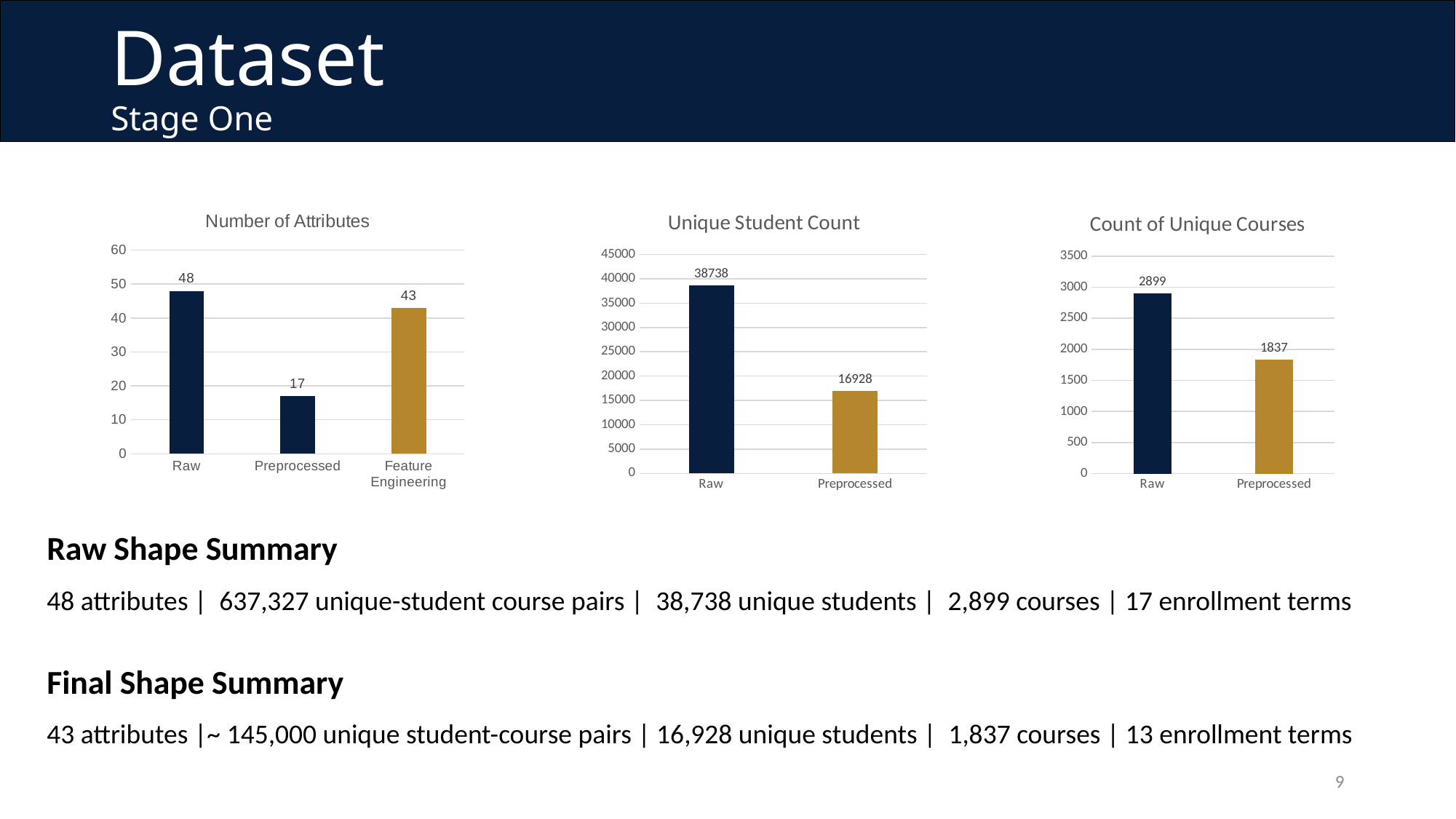
In the 'Unique Student Count' chart, what is the value for Raw? 38738 In the 'Count of Unique Courses' chart, what is the value for Preprocessed? 1837 In the 'Unique Student Count' chart, is the value for Preprocessed greater or less than 20000? less In the 'Number of Attributes' chart, how many categories are shown? 3 In the 'Number of Attributes' chart, what is the value for Feature Engineering? 43 In the 'Count of Unique Courses' chart, what is the difference between the Raw and Preprocessed values? 1062 In the 'Number of Attributes' chart, what is the difference between the Raw and Preprocessed values? 31 In the 'Number of Attributes' chart, what is the value for Preprocessed? 17 In the 'Count of Unique Courses' chart, which category has the highest value? Raw What type of chart is the 'Unique Student Count' chart? Bar chart In the 'Number of Attributes' chart, which category has the lowest value? Preprocessed In the 'Unique Student Count' chart, what is the difference between the Raw and Preprocessed values? 21810